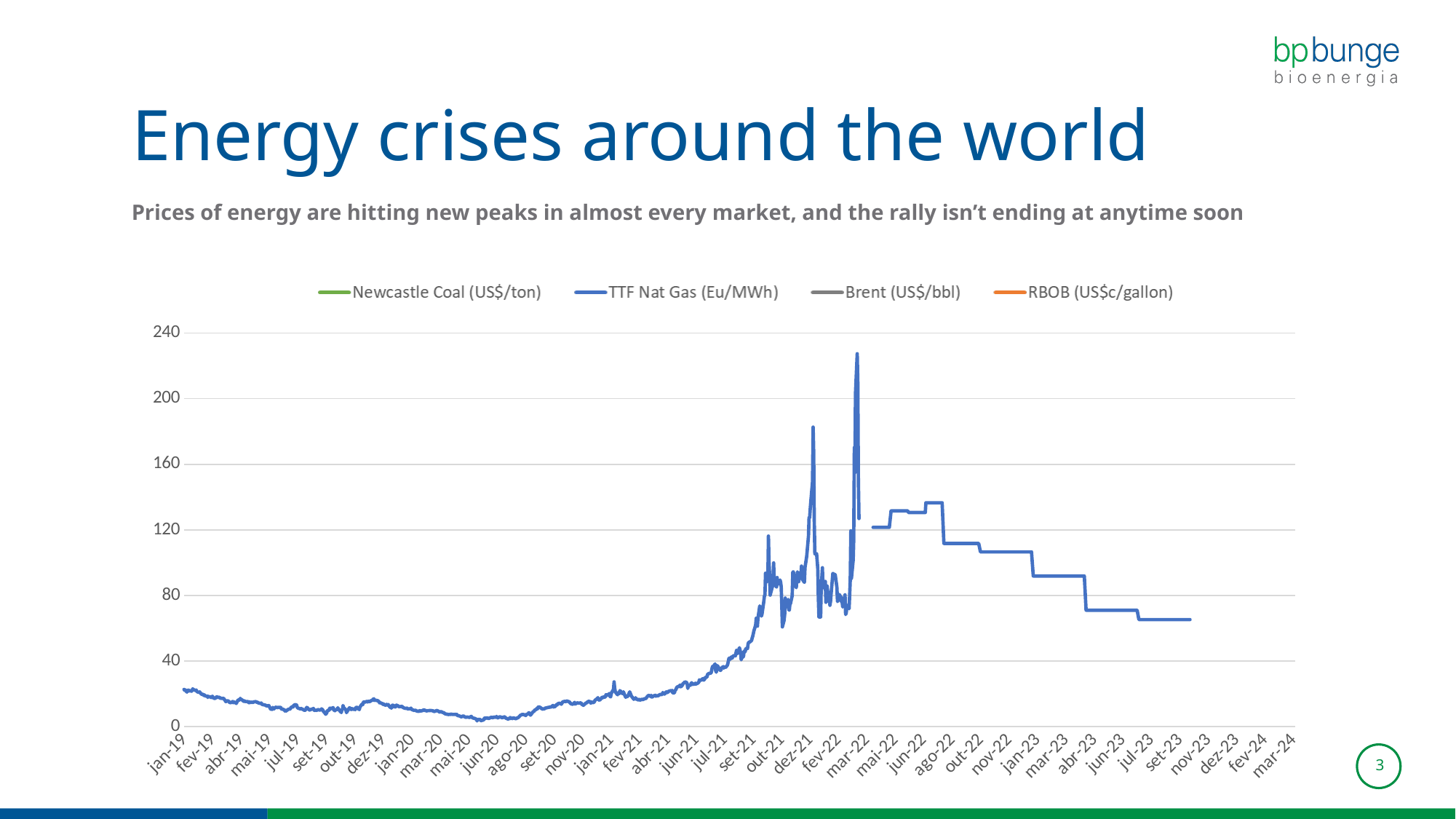
Does the TTF Nat Gas line generally rise or fall between jun-22 and set-23? fall Is the TTF Nat Gas value at jan-19 greater or less than 40? less Is the TTF Nat Gas value around mai-20 greater or less than 40? less How many series does the chart legend list? 4 Which series is plotted in blue on the chart? TTF Nat Gas (Eu/MWh) Does the TTF Nat Gas line generally rise or fall between jun-20 and set-21? rise What kind of chart is shown on the slide? line chart What unit does the legend give for the Brent series? US$/bbl Is the TTF Nat Gas value around jun-22 greater or less than 120? greater Which is larger for TTF Nat Gas: the value around jun-22 or the value around set-23? jun-22